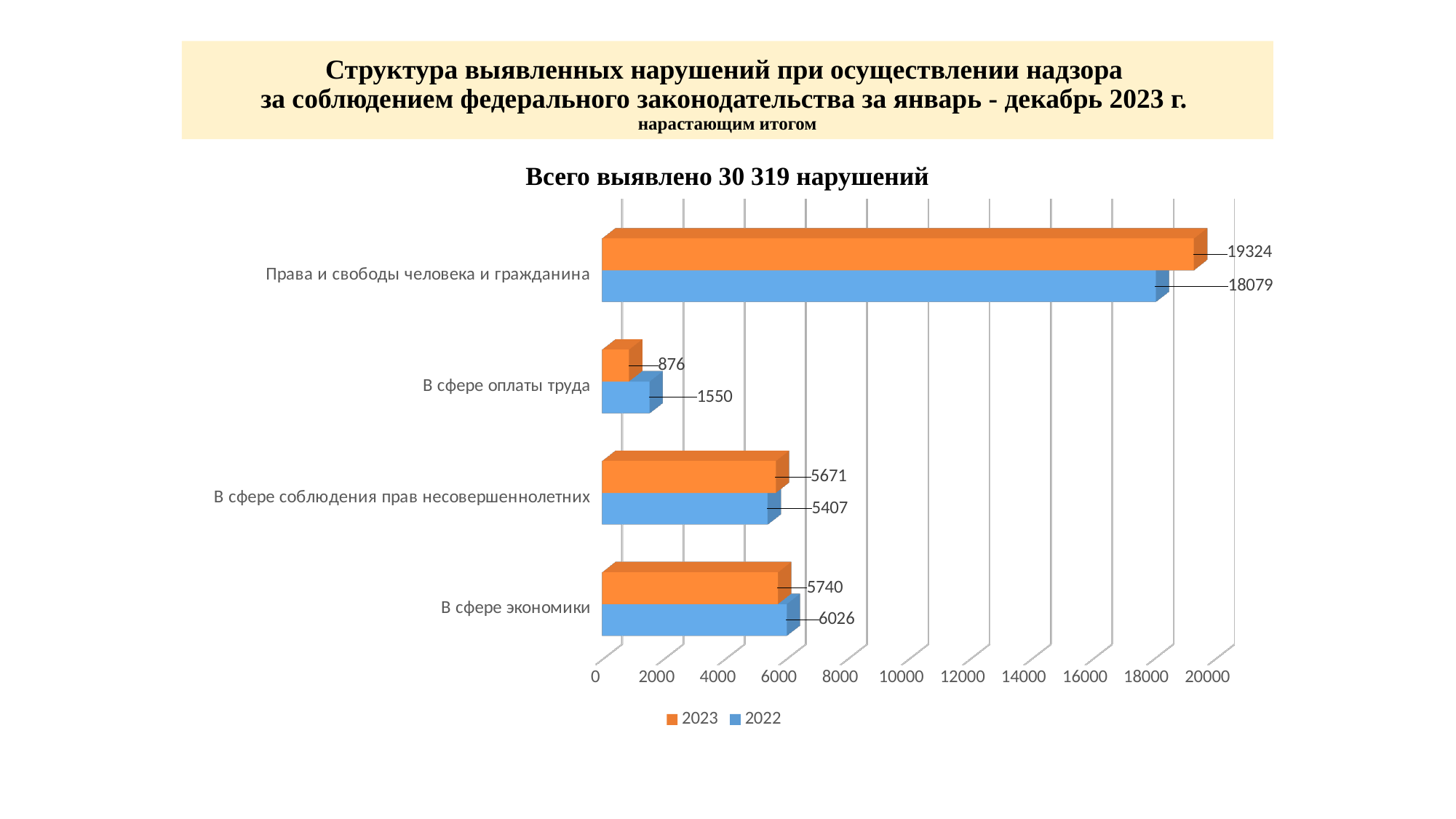
What is the difference between the 2023 and 2022 values for "Права и свободы человека и гражданина"? 1245 What is the 2023 value for "В сфере экономики"? 5740 What is the 2022 value for "В сфере оплаты труда"? 1550 What total number of violations is stated in the chart title? 30 319 Which category has the highest 2023 value? Права и свободы человека и гражданина Which category has the lowest 2022 value? В сфере оплаты труда Which is larger for "В сфере экономики": the 2023 value or the 2022 value? 2022 What is the 2023 value for "Права и свободы человека и гражданина"? 19324 What kind of chart is shown on the slide? Bar chart How many series does the legend list? 2 What is the 2022 value for "В сфере соблюдения прав несовершеннолетних"? 5407 How many categories are shown on the chart? 4